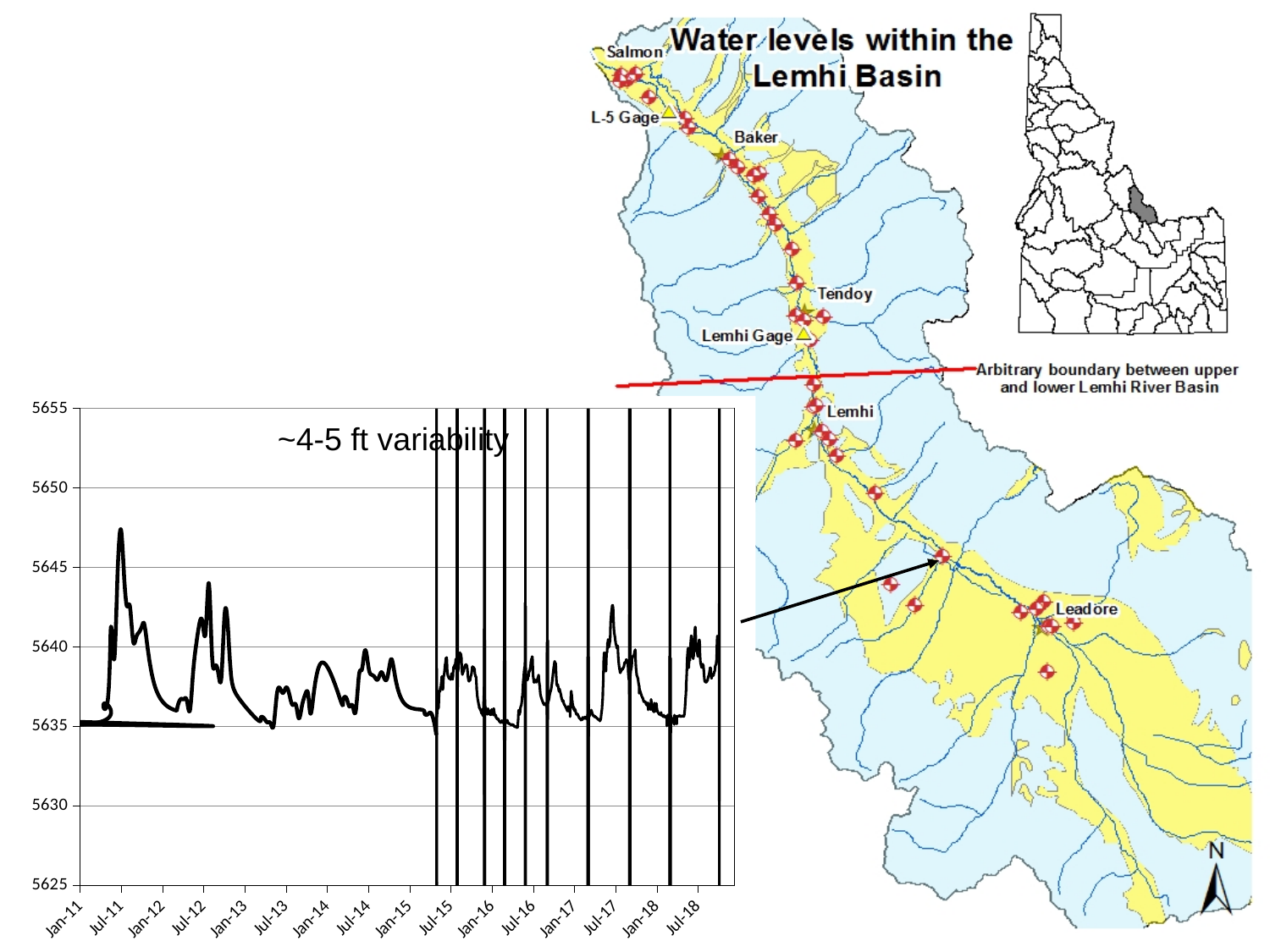
Is the water level around Jan-13 greater or less than 5640? less How many tick labels are shown on the y-axis of the line chart? 7 Does the water level line ever rise above 5650? No How many labels are shown on the x-axis of the line chart? 16 Around which x-axis label does the line chart reach its highest peak? Jul-11 What is the first label on the x-axis of the line chart? Jan-11 What is the lowest value shown on the y-axis of the line chart? 5625 Is the peak water level near Jul-11 greater or less than 5645? greater Does the water level rise or fall between the Jul-11 peak and Jan-13? fall What kind of chart is shown on the left of the slide? line chart What is the last label on the x-axis of the line chart? Jul-18 What is the highest value shown on the y-axis of the line chart? 5655